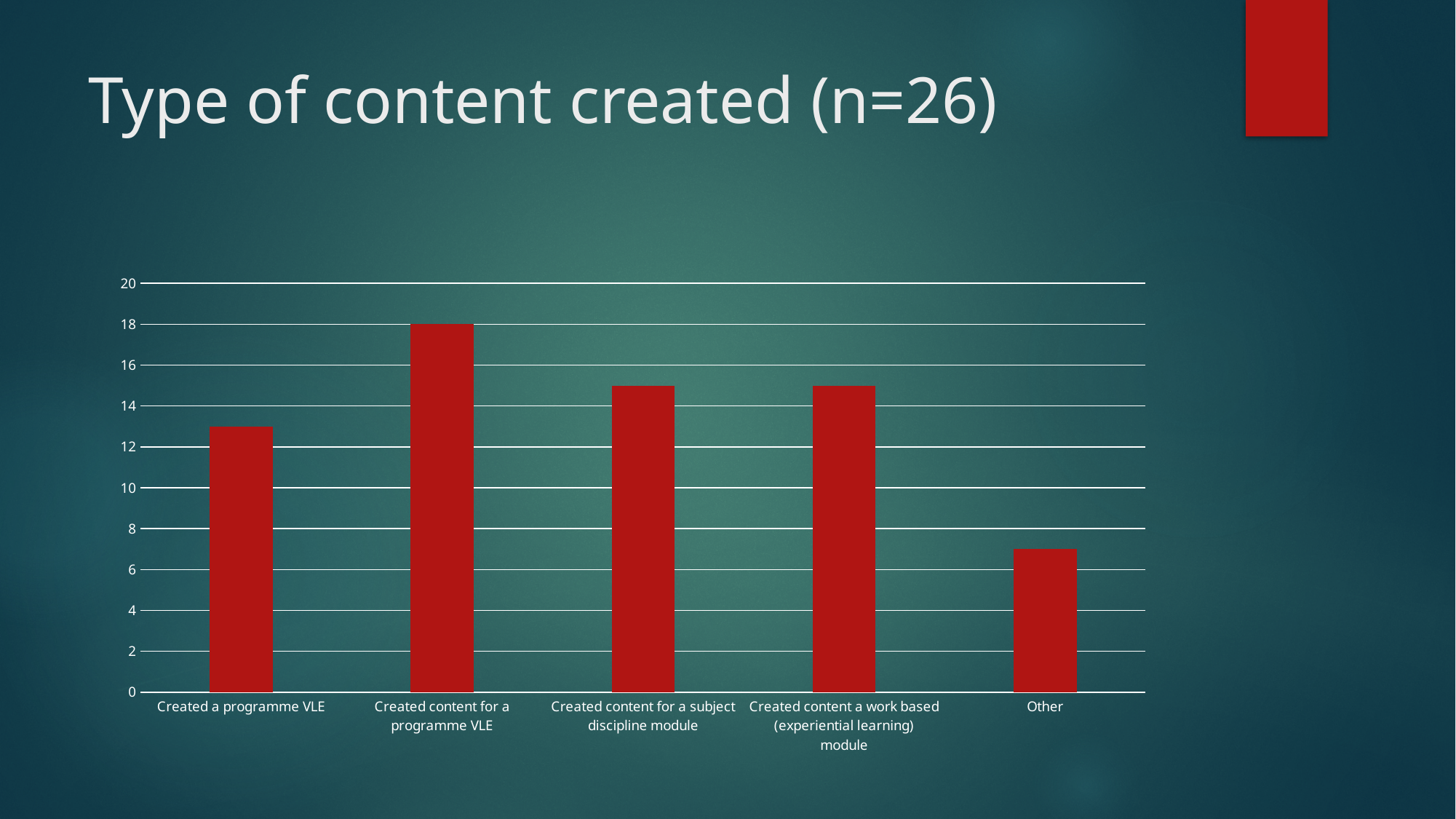
What type of chart is shown on the slide? Bar chart Which category has the highest value? Created content for a programme VLE How many categories are shown on the x axis of the chart? 5 Is the value for "Created content for a subject discipline module" greater or less than 14? greater What is the value for "Created content for a programme VLE"? 18 Is the value for "Created content a work based (experiential learning) module" greater or less than 16? less Which category has the lowest value? Other Is the value for "Created a programme VLE" greater or less than 12? greater What is the title of the chart? Type of content created (n=26) What colour are the bars in the chart? Red Which is larger, the value for "Created a programme VLE" or the value for "Other"? Created a programme VLE